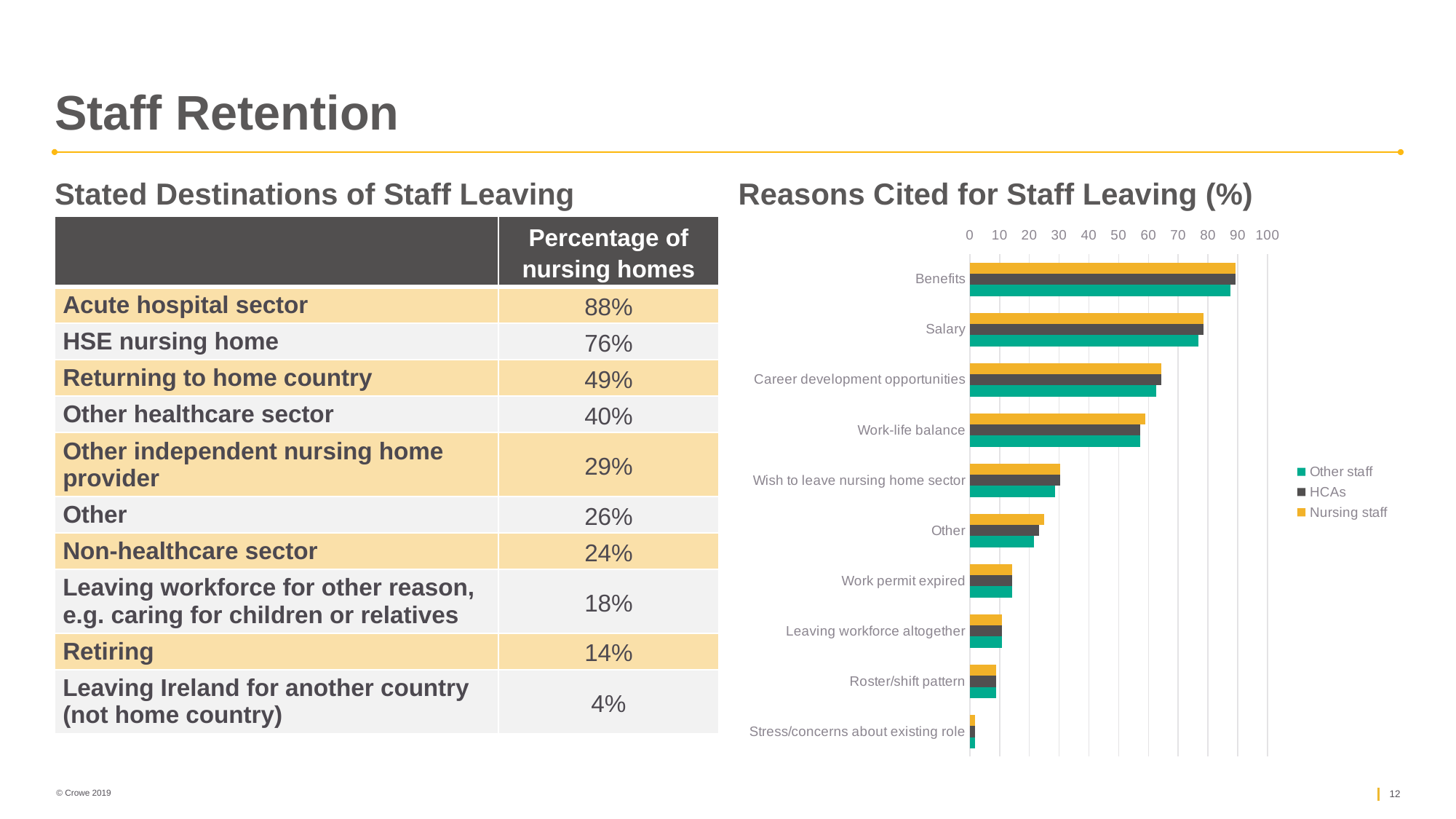
Which reason has the highest value for Nursing staff in the "Reasons Cited for Staff Leaving (%)" chart? Benefits How many series does the legend of the "Reasons Cited for Staff Leaving (%)" chart list? 3 In the "Reasons Cited for Staff Leaving (%)" chart, is the Other staff value for Benefits greater or less than 80? greater Which series is shown in yellow in the "Reasons Cited for Staff Leaving (%)" chart? Nursing staff In the "Reasons Cited for Staff Leaving (%)" chart, is the Nursing staff value for Stress/concerns about existing role greater or less than 10? less In the "Reasons Cited for Staff Leaving (%)" chart, do the values rise or fall going down the list of reasons from Benefits to Stress/concerns about existing role? fall In the "Reasons Cited for Staff Leaving (%)" chart, which is larger for HCAs: Salary or Work-life balance? Salary In the "Reasons Cited for Staff Leaving (%)" chart, is the Nursing staff value for Salary greater or less than 70? greater Which reason has the lowest value for HCAs in the "Reasons Cited for Staff Leaving (%)" chart? Stress/concerns about existing role How many reasons (categories) are plotted in the "Reasons Cited for Staff Leaving (%)" chart? 10 What kind of chart is shown under "Reasons Cited for Staff Leaving (%)"? bar chart